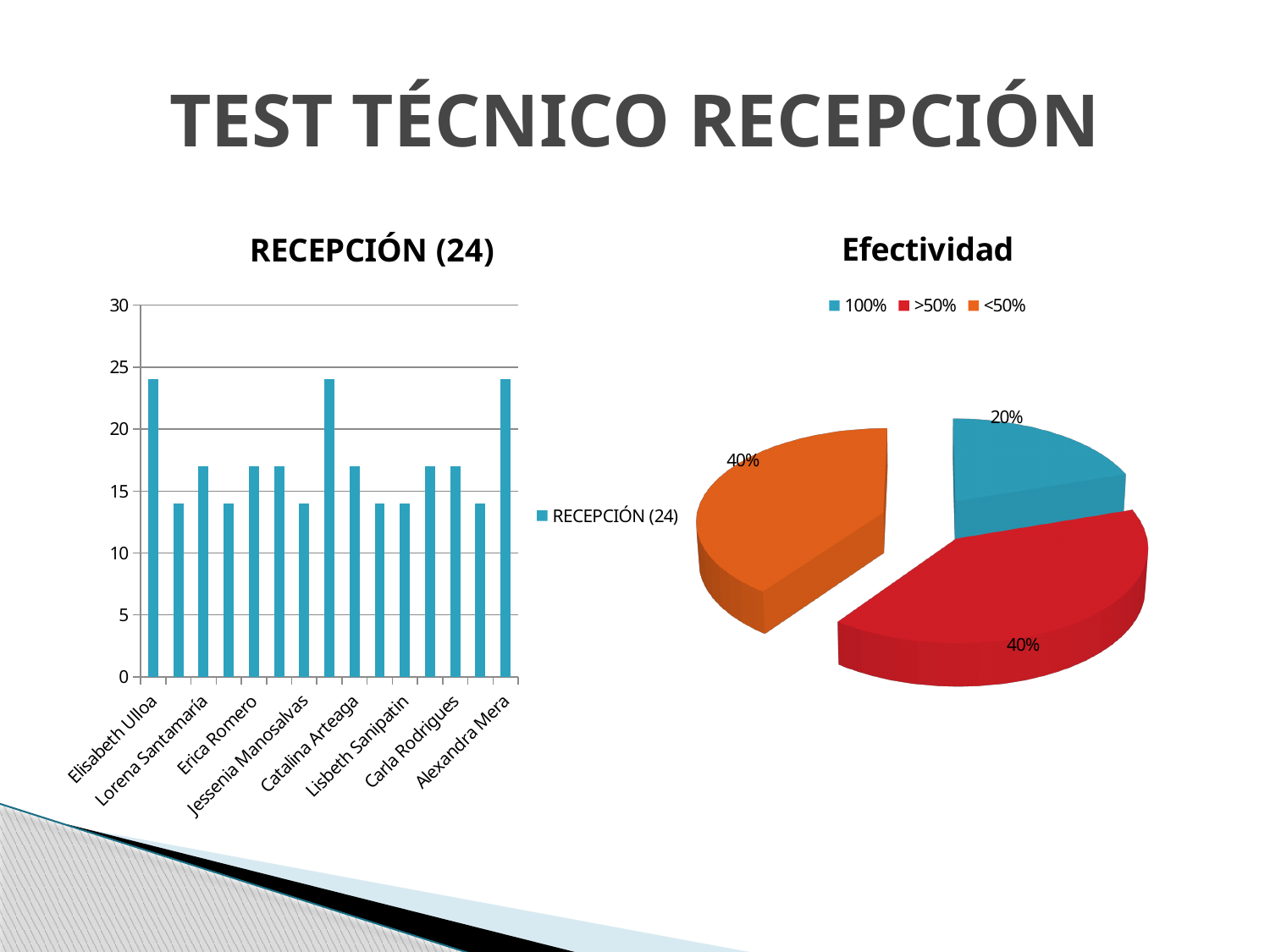
What kind of chart is the RECEPCIÓN (24) chart on the left? bar chart In the Efectividad pie chart, what share does the 100% slice have? 20% How many series does the legend of the RECEPCIÓN (24) bar chart list? 1 In the Efectividad pie chart, what share does the <50% slice have? 40% In the Efectividad pie chart, what is the difference between the >50% slice and the 100% slice? 20% In the RECEPCIÓN (24) bar chart, is the value for Elisabeth Ulloa greater or less than 20? greater How many entries does the legend of the Efectividad pie chart list? 3 In the RECEPCIÓN (24) bar chart, which is larger, the value for Alexandra Mera or the value for Lisbeth Sanipatin? Alexandra Mera What kind of chart is the Efectividad chart on the right? pie chart In the Efectividad pie chart, which slice is the smallest? 100% In the RECEPCIÓN (24) bar chart, is the value for Jessenia Manosalvas greater or less than 15? less In the Efectividad pie chart, what share does the >50% slice have? 40%